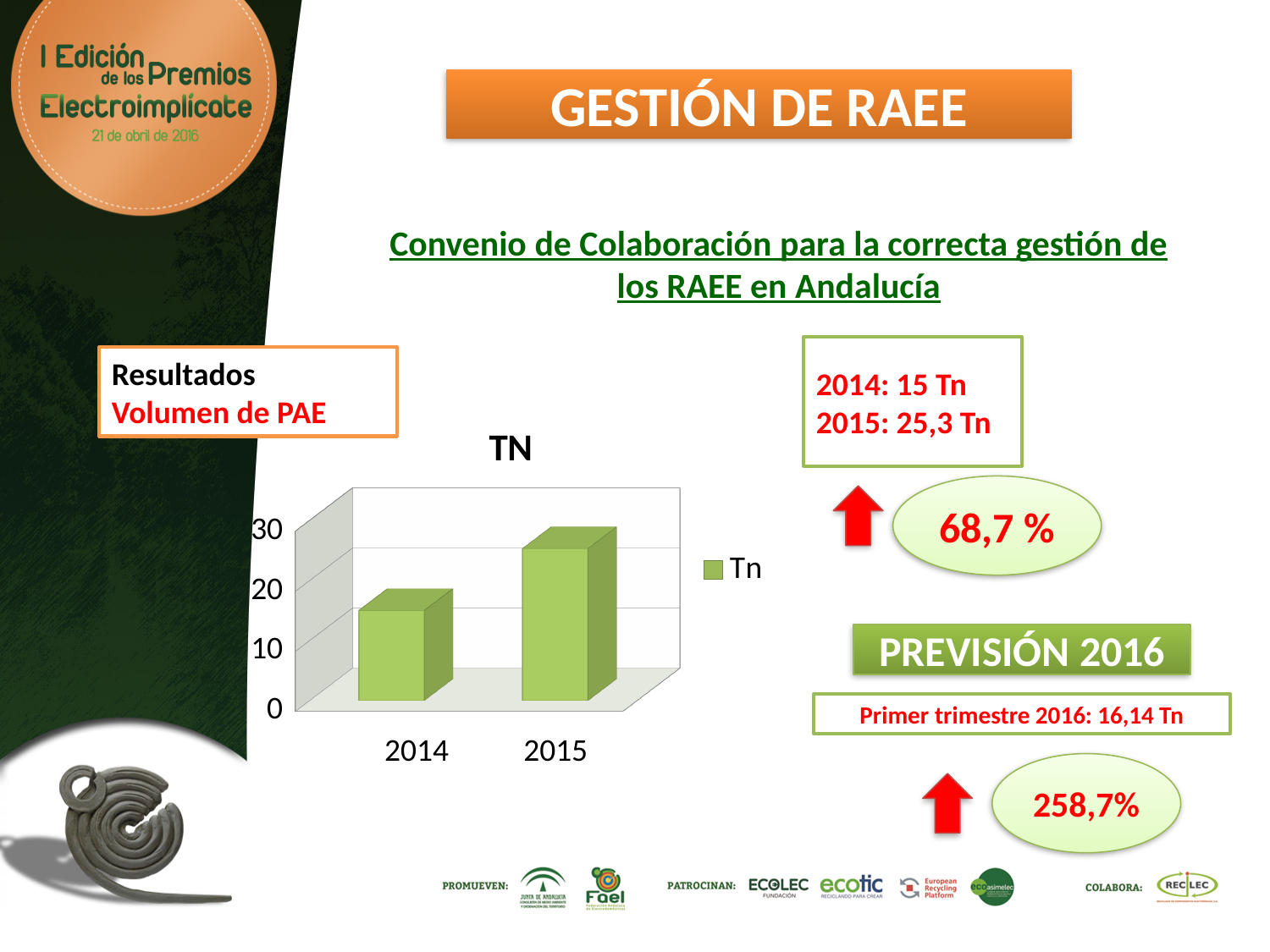
What is the name of the series in the chart legend? Tn How many categories are shown on the x axis of the chart? 2 Is the value for 2015 greater or less than 20? greater Is the value for 2014 greater or less than 20? less Which is larger, the bar for 2014 or the bar for 2015? 2015 What is the title of the chart? TN According to the slide, what is the value in Tn for 2015? 25,3 Tn Which year has the lowest bar in the chart? 2014 Which year has the highest bar in the chart? 2015 Do the values rise or fall from 2014 to 2015? rise What kind of chart is shown on the slide? bar chart How many series does the chart legend list? 1